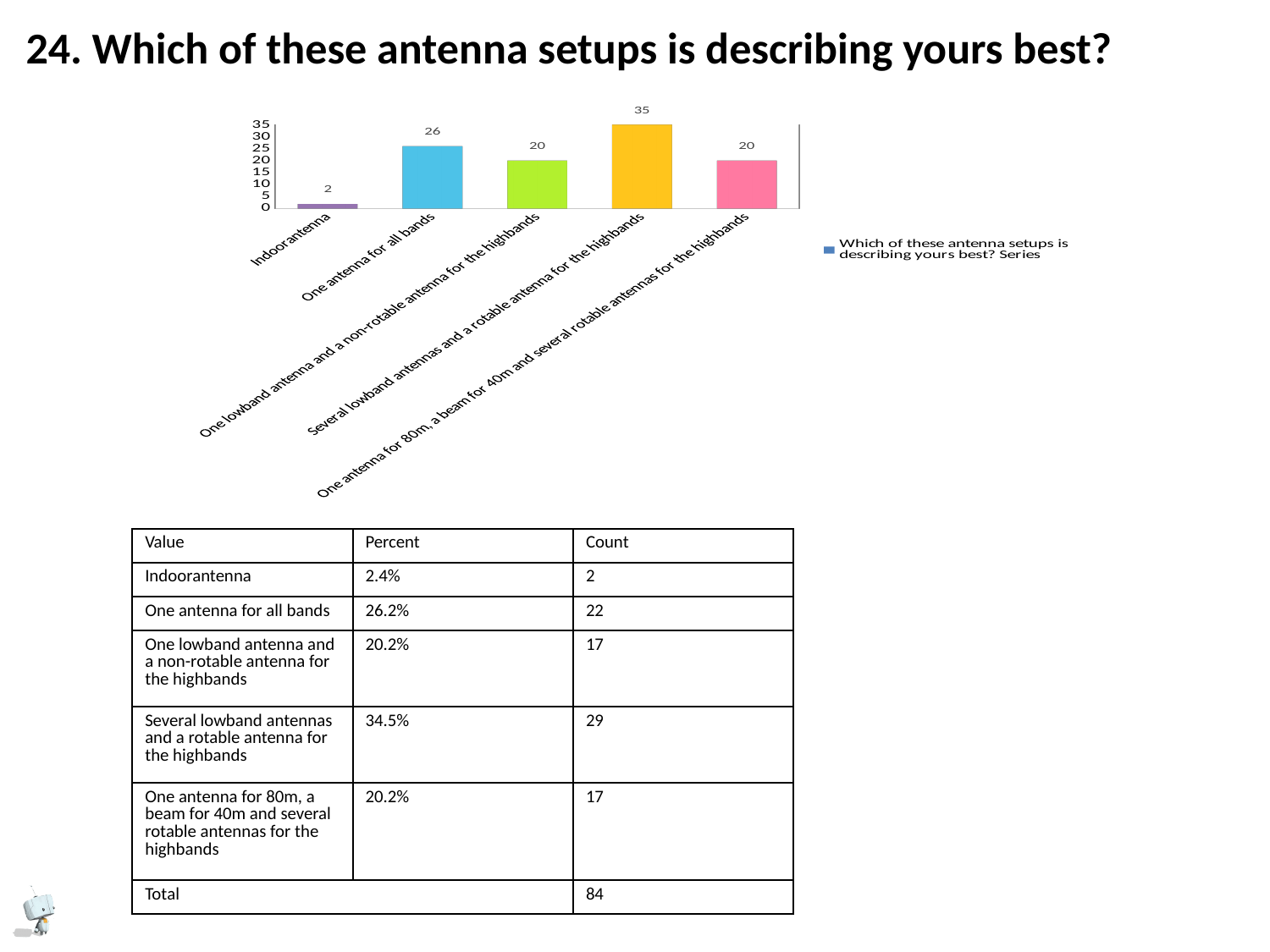
What kind of chart is shown on the slide? Bar chart Which is larger in the chart: the value for One antenna for all bands or the value for Indoorantenna? One antenna for all bands What value is shown for One antenna for all bands in the chart? 26 How many categories are plotted in the chart? 5 What value is shown for Several lowband antennas and a rotable antenna for the highbands in the chart? 35 Which category has the highest value in the chart? Several lowband antennas and a rotable antenna for the highbands What value is shown for Indoorantenna in the chart? 2 How many series does the chart legend list? 1 What is the difference between the values for Several lowband antennas and a rotable antenna for the highbands and One antenna for all bands? 9 What value is shown for One lowband antenna and a non-rotable antenna for the highbands in the chart? 20 What is the difference between the values for One antenna for all bands and Indoorantenna in the chart? 24 Which category has the lowest value in the chart? Indoorantenna